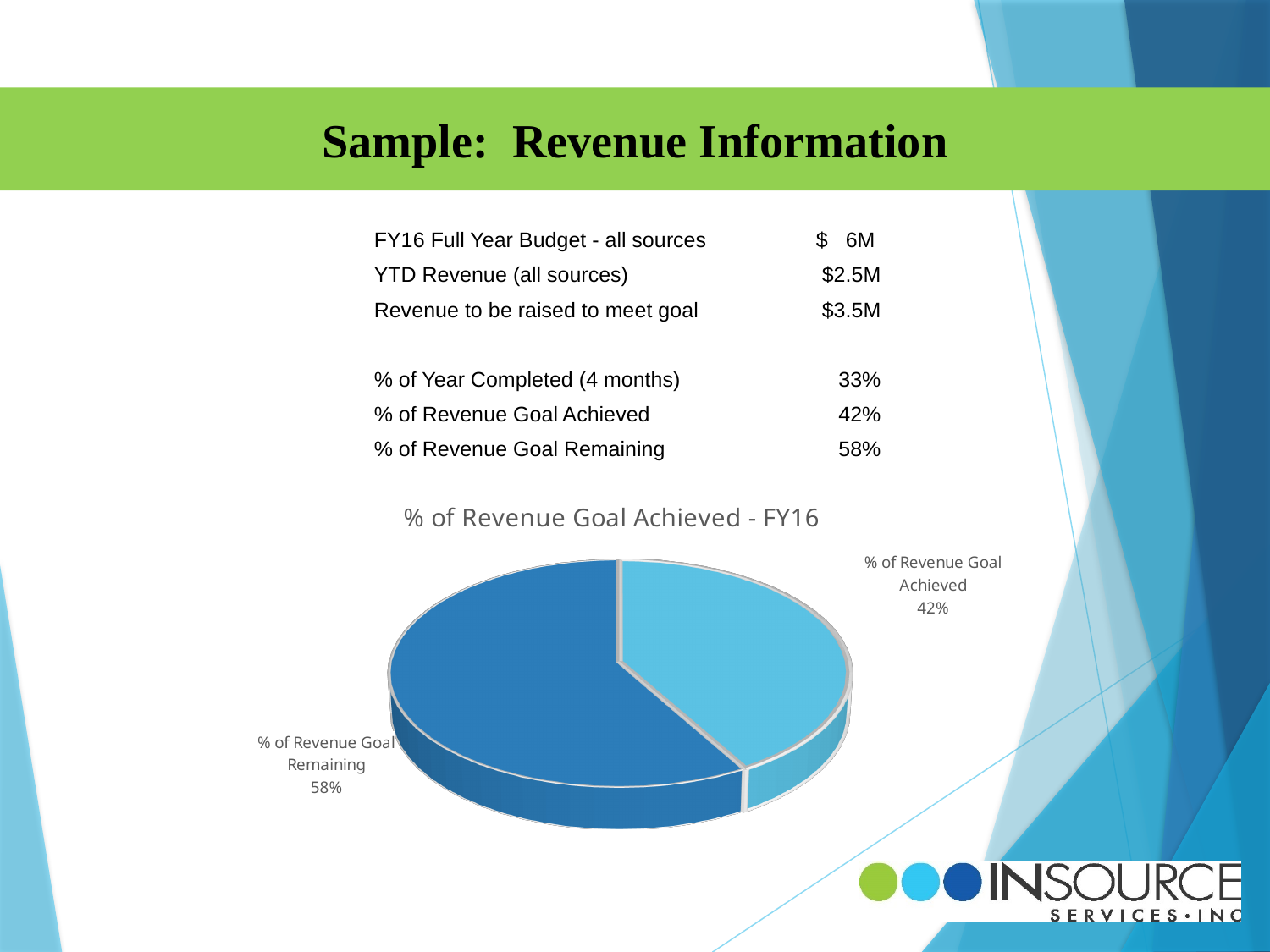
Which slice of the pie is shown in the lighter blue colour? % of Revenue Goal Achieved Which is larger, the "% of Revenue Goal Achieved" slice or the "% of Revenue Goal Remaining" slice? % of Revenue Goal Remaining What is the title of the chart? % of Revenue Goal Achieved - FY16 What share of the pie is labelled "% of Revenue Goal Achieved"? 42% What is the total of the two slices shown in the pie chart? 100% What share of the pie is labelled "% of Revenue Goal Remaining"? 58% Which slice of the pie is the largest? % of Revenue Goal Remaining What is the difference in percentage points between the "% of Revenue Goal Remaining" slice and the "% of Revenue Goal Achieved" slice? 16 Which slice of the pie is the smallest? % of Revenue Goal Achieved How many slices does the pie chart have? 2 What type of chart is shown on the slide? pie chart